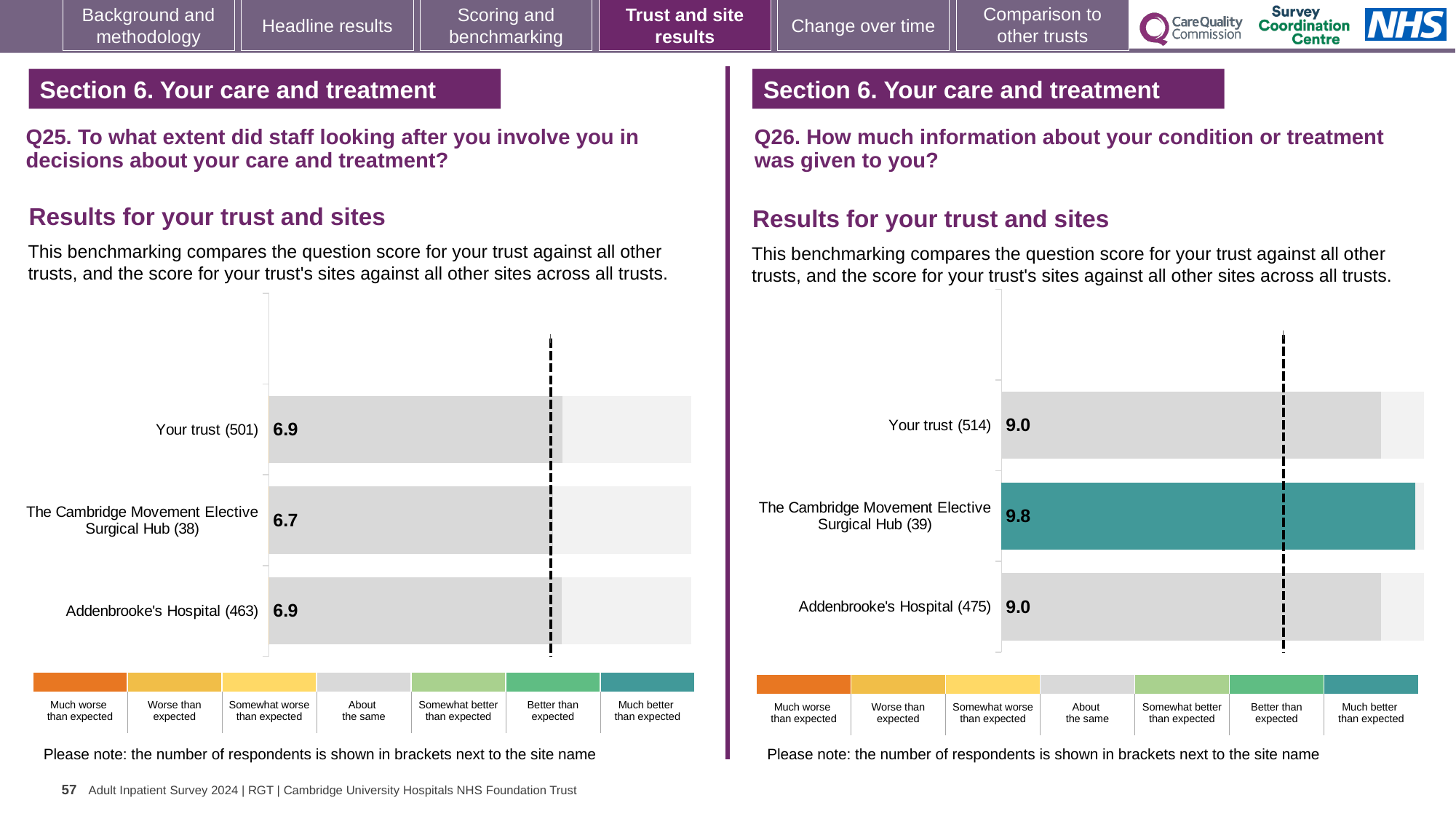
On the Q25 chart (left), what is the score for The Cambridge Movement Elective Surgical Hub? 6.7 On the Q26 chart (right), what is the score for Addenbrooke's Hospital? 9.0 What type of chart is used on the Q25 chart (left)? Bar chart On the Q25 chart (left), what is the score for Your trust? 6.9 On the Q26 chart (right), which site or trust has the highest score? The Cambridge Movement Elective Surgical Hub On the Q26 chart (right), how many respondents are shown in brackets for Addenbrooke's Hospital? 475 On the Q25 chart (left), what is the difference between the score for Addenbrooke's Hospital and the score for The Cambridge Movement Elective Surgical Hub? 0.2 On the Q26 chart (right), what is the difference between the score for The Cambridge Movement Elective Surgical Hub and the score for Your trust? 0.8 On the Q25 chart (left), which site or trust has the lowest score? The Cambridge Movement Elective Surgical Hub On the Q25 chart (left), which has the larger score: Your trust or The Cambridge Movement Elective Surgical Hub? Your trust How many bars are plotted on the Q26 chart (right)? 3 On the Q26 chart (right), what is the score for The Cambridge Movement Elective Surgical Hub? 9.8